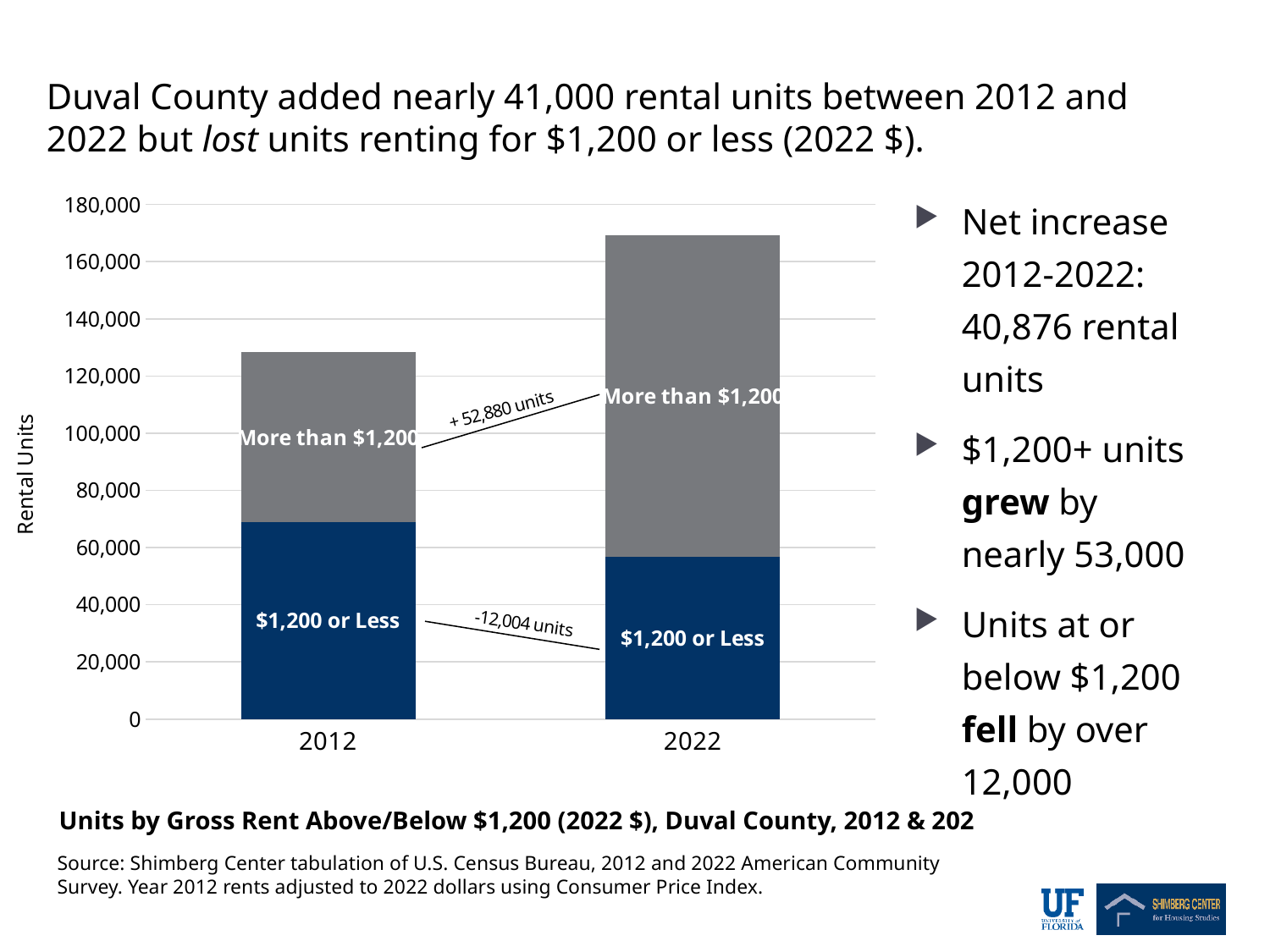
Is the total number of rental units in 2012 greater or less than 120,000? greater What kind of chart is shown on the slide? Stacked bar chart How many rent segments (series) are stacked in each bar? 2 Which year has more units renting for $1,200 or less, 2012 or 2022? 2012 Which year has the taller total bar, 2012 or 2022? 2022 Is the total number of rental units in 2022 greater or less than 160,000? greater According to the annotation on the chart, by how many units did the 'More than $1,200' segment change from 2012 to 2022? + 52,880 units Is the 'More than $1,200' segment in 2022 greater or less than 100,000 units? greater In 2022, which segment is larger: '$1,200 or Less' or 'More than $1,200'? More than $1,200 How many years (categories) are shown on the x axis of the chart? 2 According to the annotation on the chart, by how many units did the '$1,200 or Less' segment change from 2012 to 2022? -12,004 units